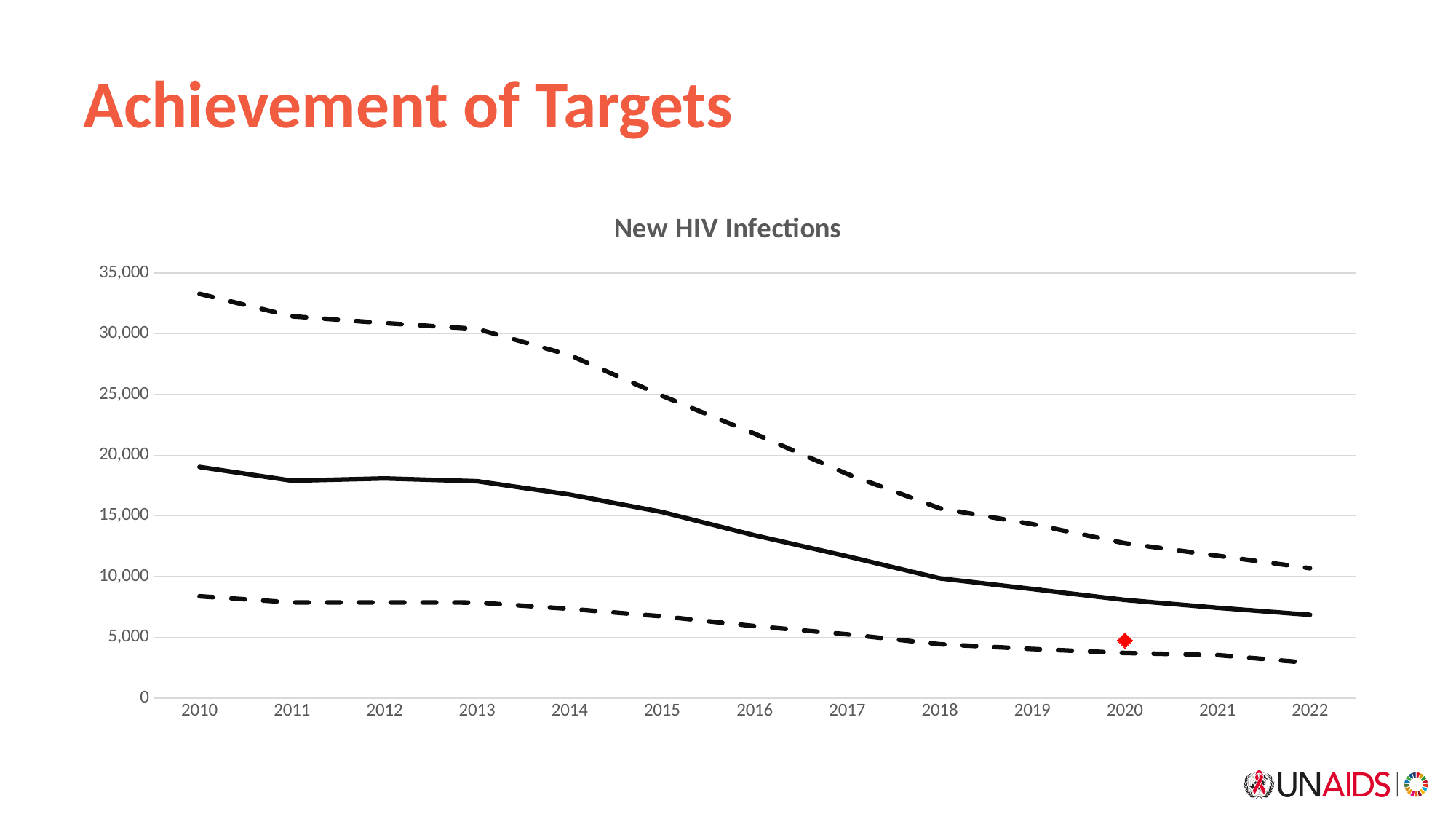
Is the value of the solid line in 2010 greater or less than 20,000? less Is the value of the lower dashed line in 2022 greater or less than 5,000? less How many years are shown along the x axis of the chart? 13 Is the value of the upper dashed line in 2010 greater or less than 30,000? greater What is the title of the chart? New HIV Infections Do the values of the solid line rise or fall from 2010 to 2022? fall In which year does the solid line reach its lowest value? 2022 In which year does the solid line reach its highest value? 2010 At which year is the red diamond marker plotted on the chart? 2020 What kind of chart is shown on the slide? line chart